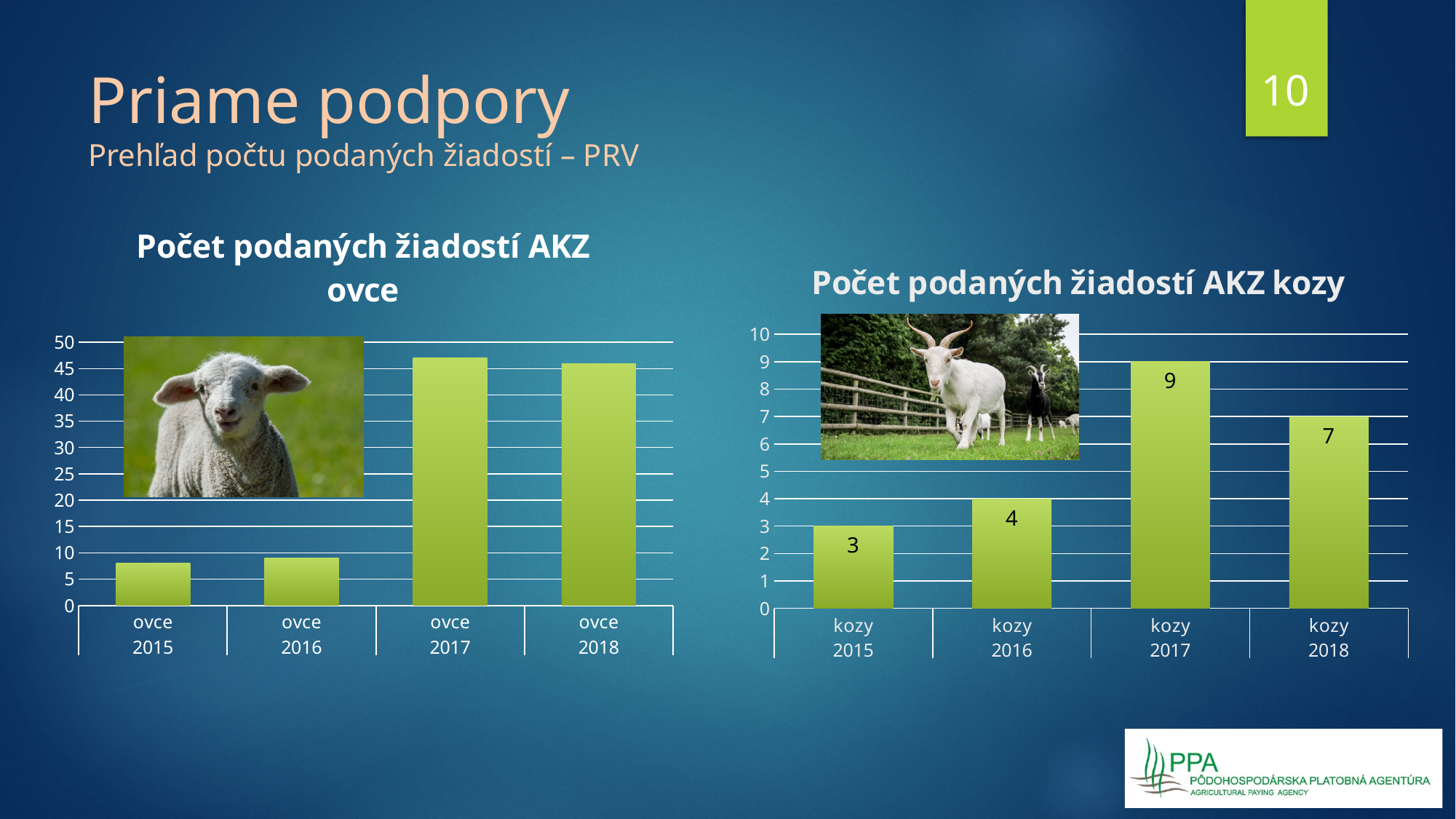
In the chart 'Počet podaných žiadostí AKZ kozy', what is the value for kozy 2015? 3 In the chart 'Počet podaných žiadostí AKZ ovce', is the value for ovce 2017 greater or less than 40? greater In the chart 'Počet podaných žiadostí AKZ ovce', which is larger: the value for ovce 2016 or ovce 2018? ovce 2018 In the chart 'Počet podaných žiadostí AKZ kozy', which year has the lowest value? kozy 2015 In the chart 'Počet podaných žiadostí AKZ kozy', what is the difference between the values for kozy 2017 and kozy 2015? 6 In the chart 'Počet podaných žiadostí AKZ kozy', how many bars are plotted? 4 In the chart 'Počet podaných žiadostí AKZ kozy', which year has the highest value? kozy 2017 In the chart 'Počet podaných žiadostí AKZ kozy', what is the value for kozy 2018? 7 What type of chart is 'Počet podaných žiadostí AKZ ovce'? bar chart In the chart 'Počet podaných žiadostí AKZ kozy', which is larger: the value for kozy 2016 or kozy 2018? kozy 2018 In the chart 'Počet podaných žiadostí AKZ ovce', is the value for ovce 2015 greater or less than 10? less In the chart 'Počet podaných žiadostí AKZ kozy', what is the value for kozy 2017? 9